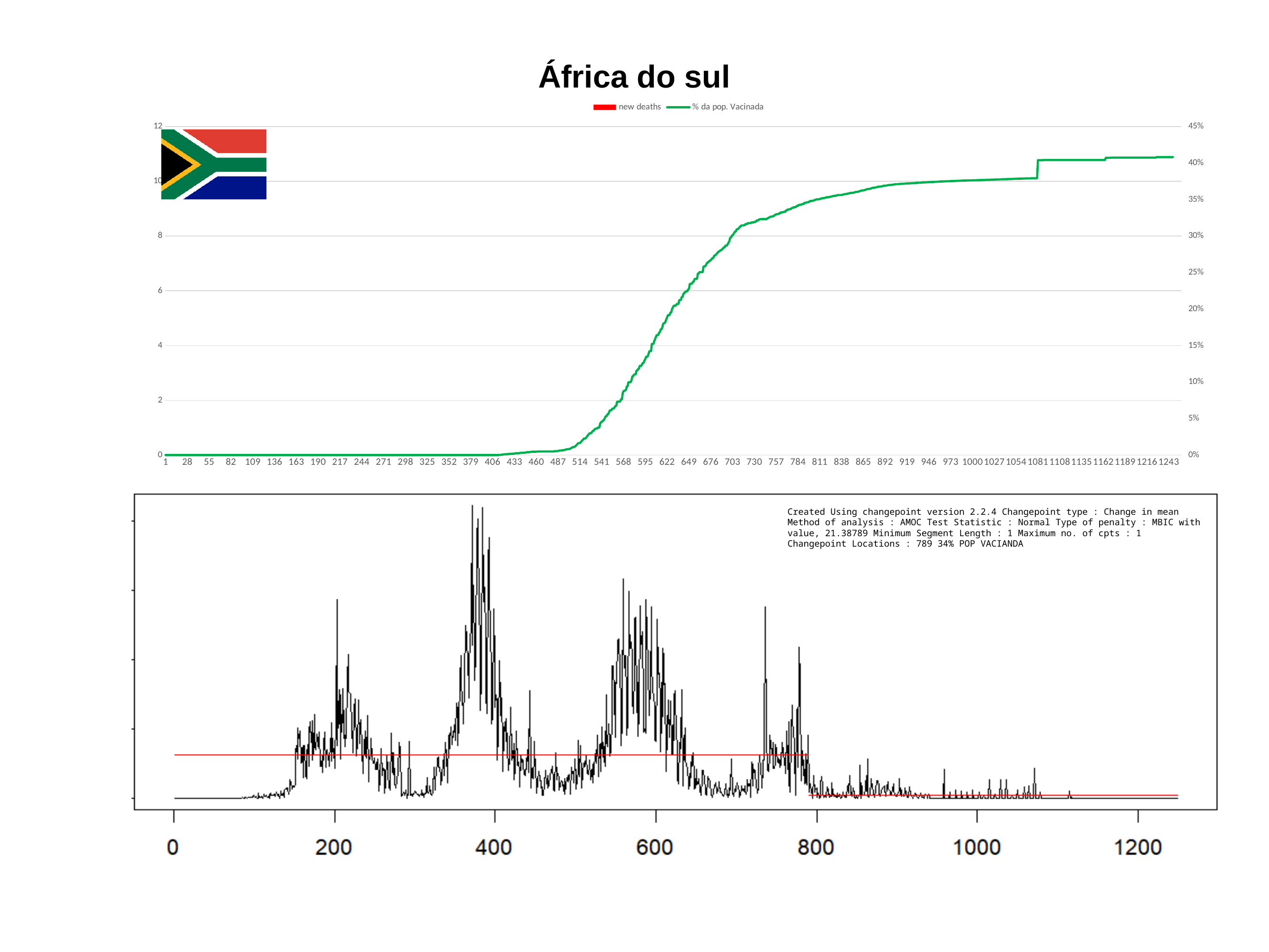
In the bottom chart, what changepoint location is reported in the annotation text? 789 In the top chart, what is the highest tick label on the right-hand axis? 45% In the top chart, is the value of '% da pop. Vacinada' at x = 703 greater or less than 25%? greater In the top chart, is the value of '% da pop. Vacinada' at x = 541 greater or less than 10%? less In the top chart, is the value of '% da pop. Vacinada' at x = 406 greater or less than 5%? less What kind of chart is the top chart titled 'África do sul'? line chart In the bottom chart, what penalty value is stated in the annotation text? 21.38789 What is the title of the top chart? África do sul In the top chart, does the '% da pop. Vacinada' line rise or fall along the x axis? rise In the top chart, what colour is the '% da pop. Vacinada' series in the legend? green In the top chart, how many series does the legend list? 2